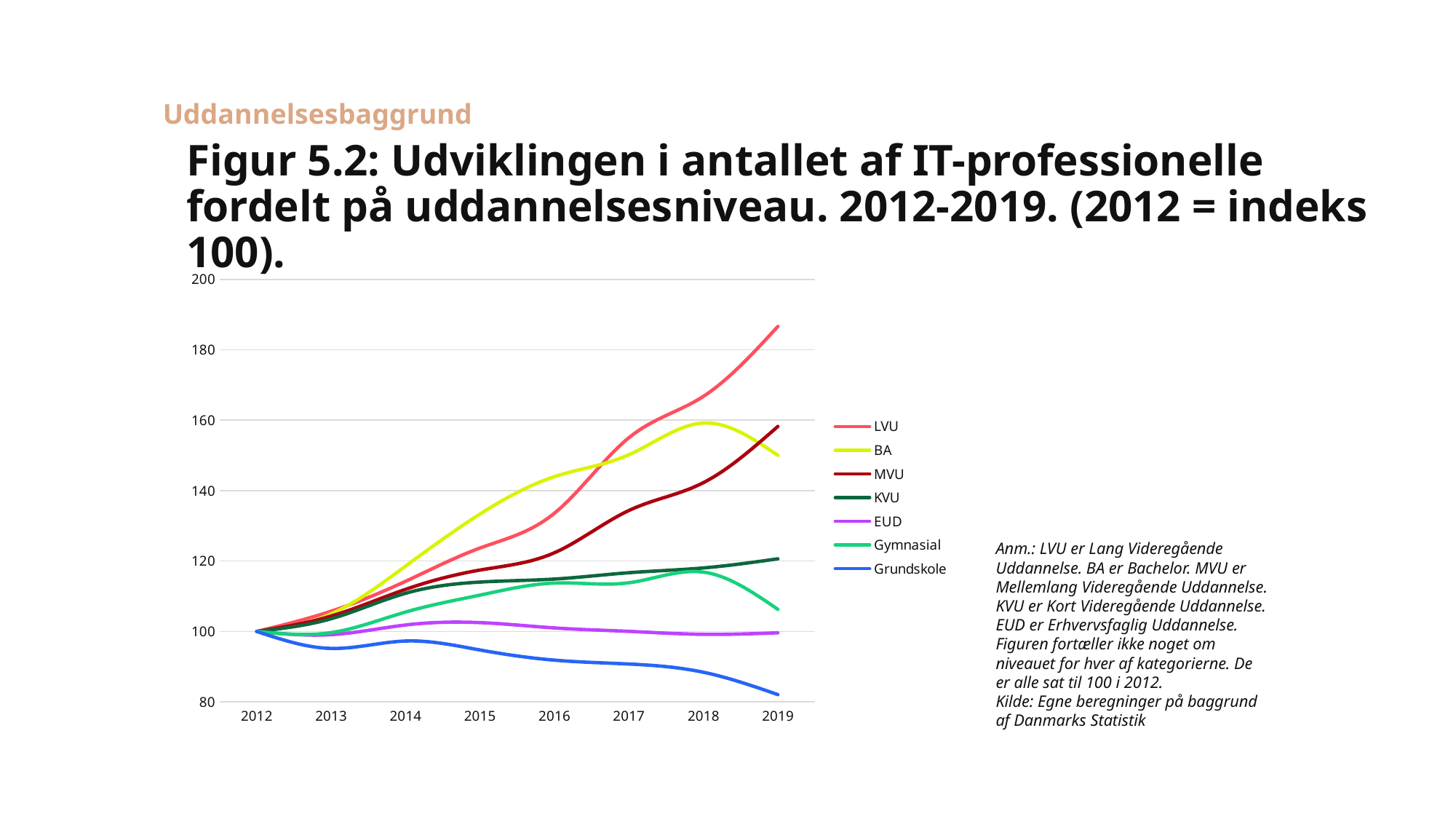
Which series is drawn in blue in the legend? Grundskole How many series does the legend list? 7 Does the Grundskole series rise or fall from 2012 to 2019? Fall What kind of chart is shown on the slide? Line chart Which series has the lowest value in 2019? Grundskole Which series has the highest value in 2019? LVU How many years are plotted along the x axis? 8 What is the index value of every series in 2012? 100 Is the value for Grundskole in 2019 greater or less than 90? less Is the value for LVU in 2019 greater or less than 180? greater Which is larger in 2016, the value for BA or the value for MVU? BA Is the value for BA in 2019 greater or less than 160? less